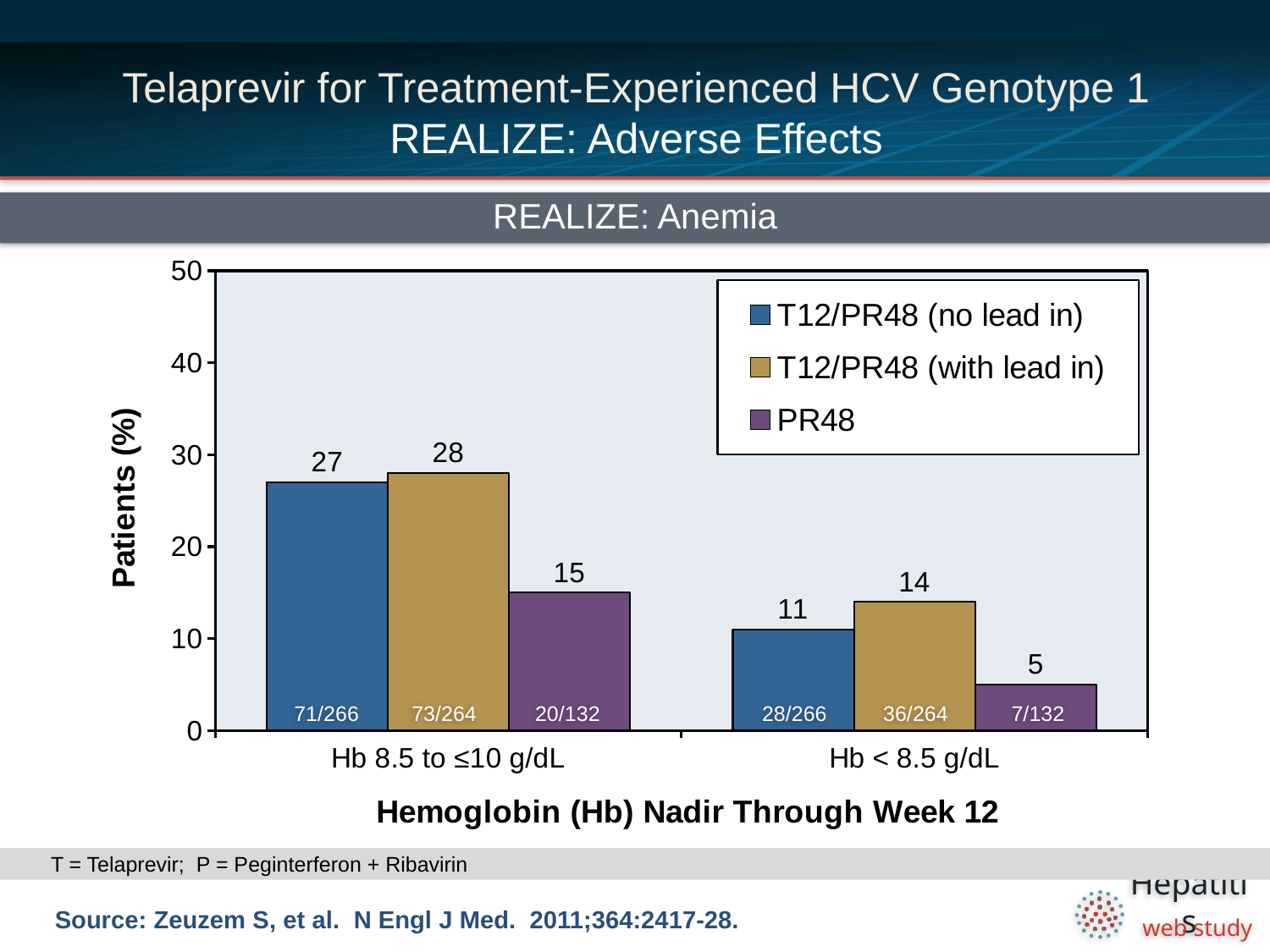
What is the label of the y axis? Patients (%) Which treatment group had the lowest percentage of patients with a hemoglobin nadir < 8.5 g/dL? PR48 What is the difference in percentage points between the T12/PR48 (with lead in) and PR48 groups for the Hb 8.5 to ≤10 g/dL category? 13 What fraction is printed inside the PR48 bar for the Hb < 8.5 g/dL category? 7/132 What percentage of patients in the PR48 group had a hemoglobin nadir < 8.5 g/dL? 5 What percentage of patients in the T12/PR48 (no lead in) group had a hemoglobin nadir of 8.5 to ≤10 g/dL? 27 How many hemoglobin nadir categories are shown on the x axis? 2 Which treatment group had the highest percentage of patients with a hemoglobin nadir of 8.5 to ≤10 g/dL? T12/PR48 (with lead in) What percentage of patients in the T12/PR48 (with lead in) group had a hemoglobin nadir < 8.5 g/dL? 14 How many series does the legend list? 3 Which is larger for the Hb < 8.5 g/dL category: the T12/PR48 (no lead in) value or the PR48 value? T12/PR48 (no lead in) What kind of chart is shown on the slide? Bar chart